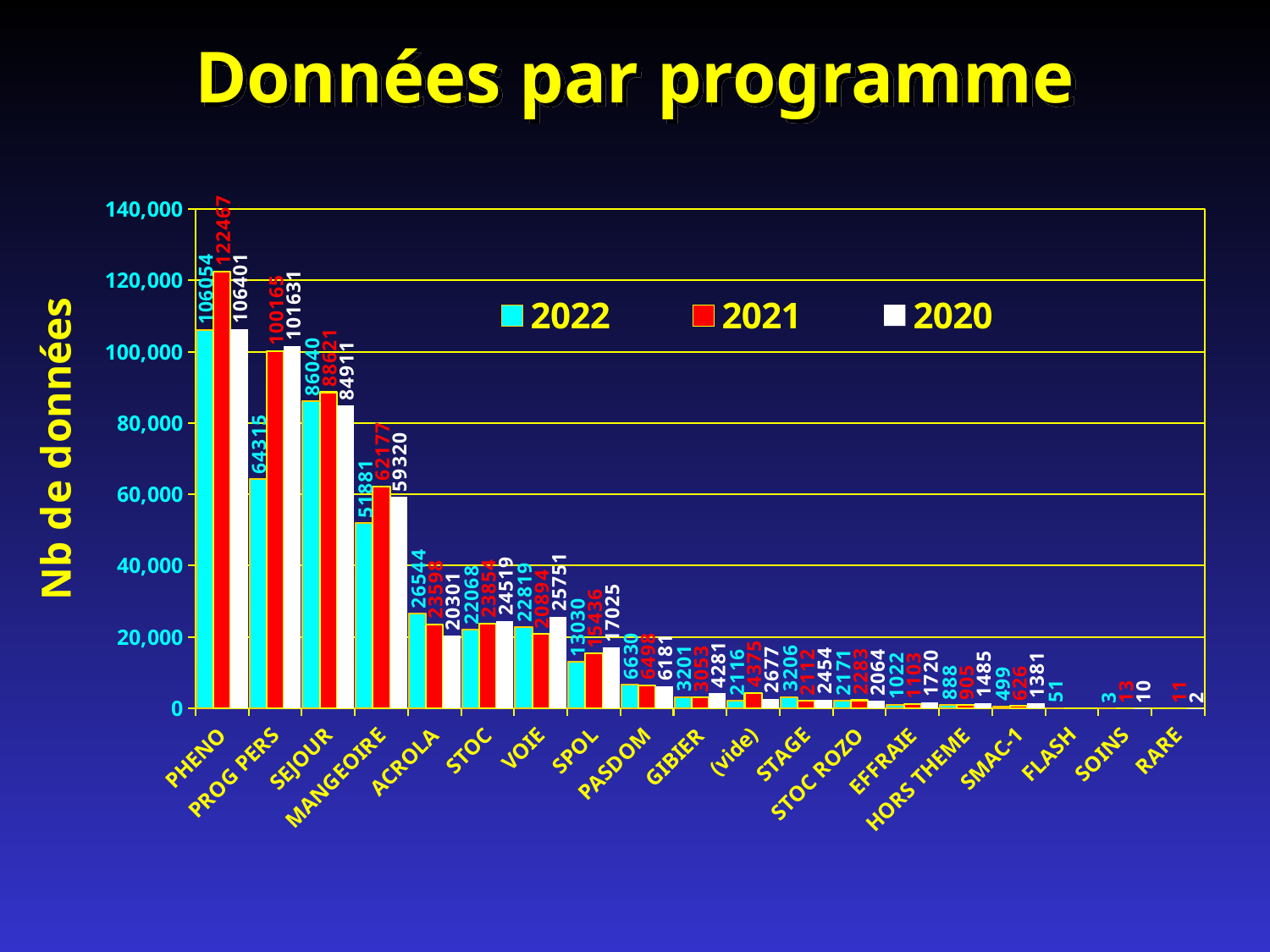
What is the 2020 value for MANGEOIRE? 59320 What is the 2022 value for SEJOUR? 86040 Is the 2022 value for PROG PERS greater or less than 80,000? less How many series does the legend list? 3 What kind of chart is shown on the slide? bar chart What is the 2021 value for PHENO? 122467 Which programme has the highest 2021 value? PHENO What is the 2020 value for SPOL? 17025 What is the difference between the 2021 and 2020 values for PHENO? 16066 How many programme categories are shown on the x axis? 19 What is the title of the y axis? Nb de données Which is larger, the 2022 value for ACROLA or the 2022 value for STOC? ACROLA